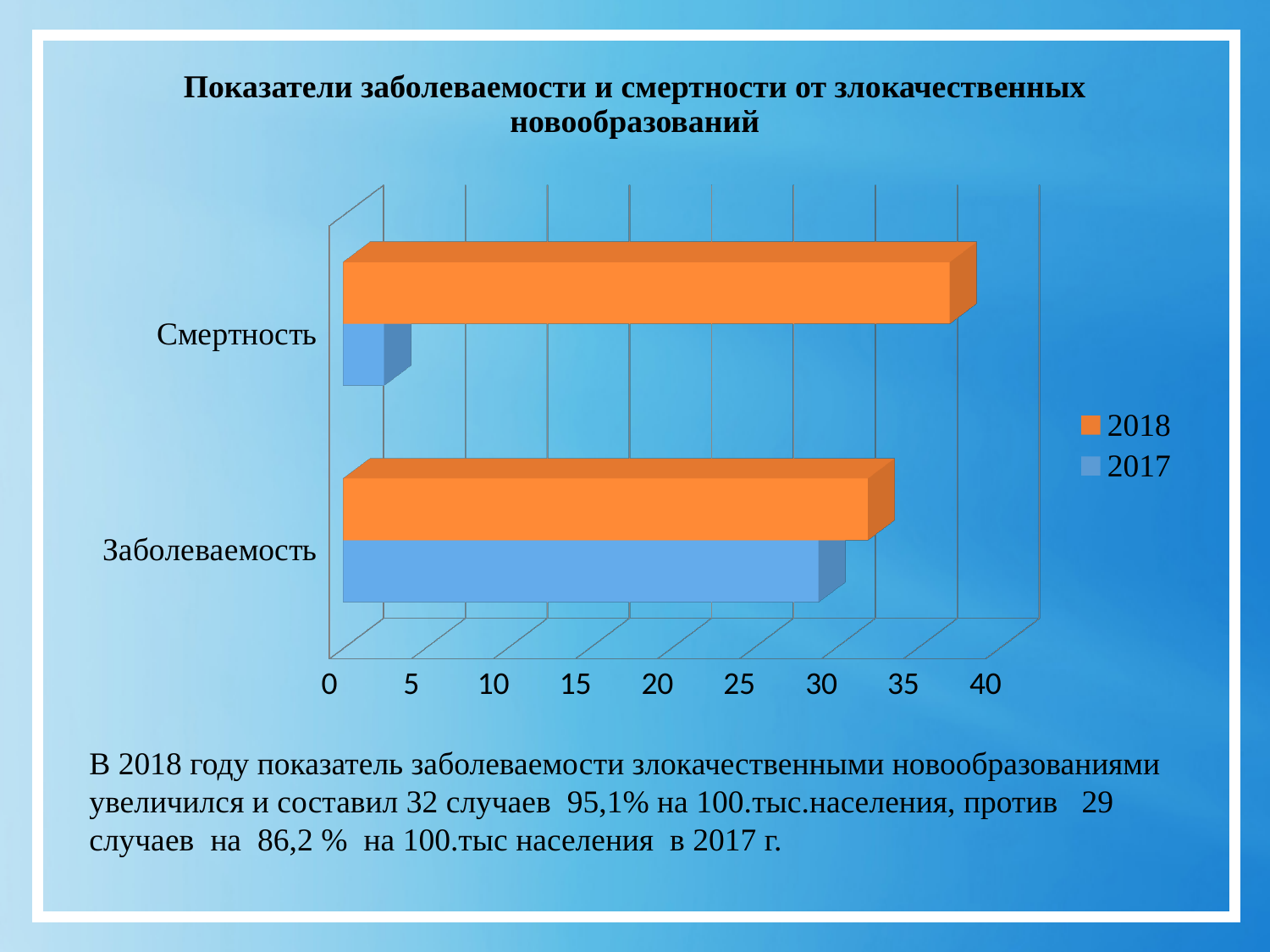
For Заболеваемость, which series has the larger value, 2018 or 2017? 2018 Is the 2018 value for Заболеваемость greater or less than 30? greater How many categories are shown on the chart? 2 What kind of chart is shown on the slide? bar chart Is the 2017 value for Смертность greater or less than 5? less For Смертность, which series has the larger value, 2018 or 2017? 2018 How many series does the chart legend list? 2 Is the 2017 value for Заболеваемость greater or less than 25? greater Which series is shown in orange in the chart legend? 2018 What is the title of the chart? Показатели заболеваемости и смертности от злокачественных новообразований Which category has the lowest value for the 2017 series? Смертность